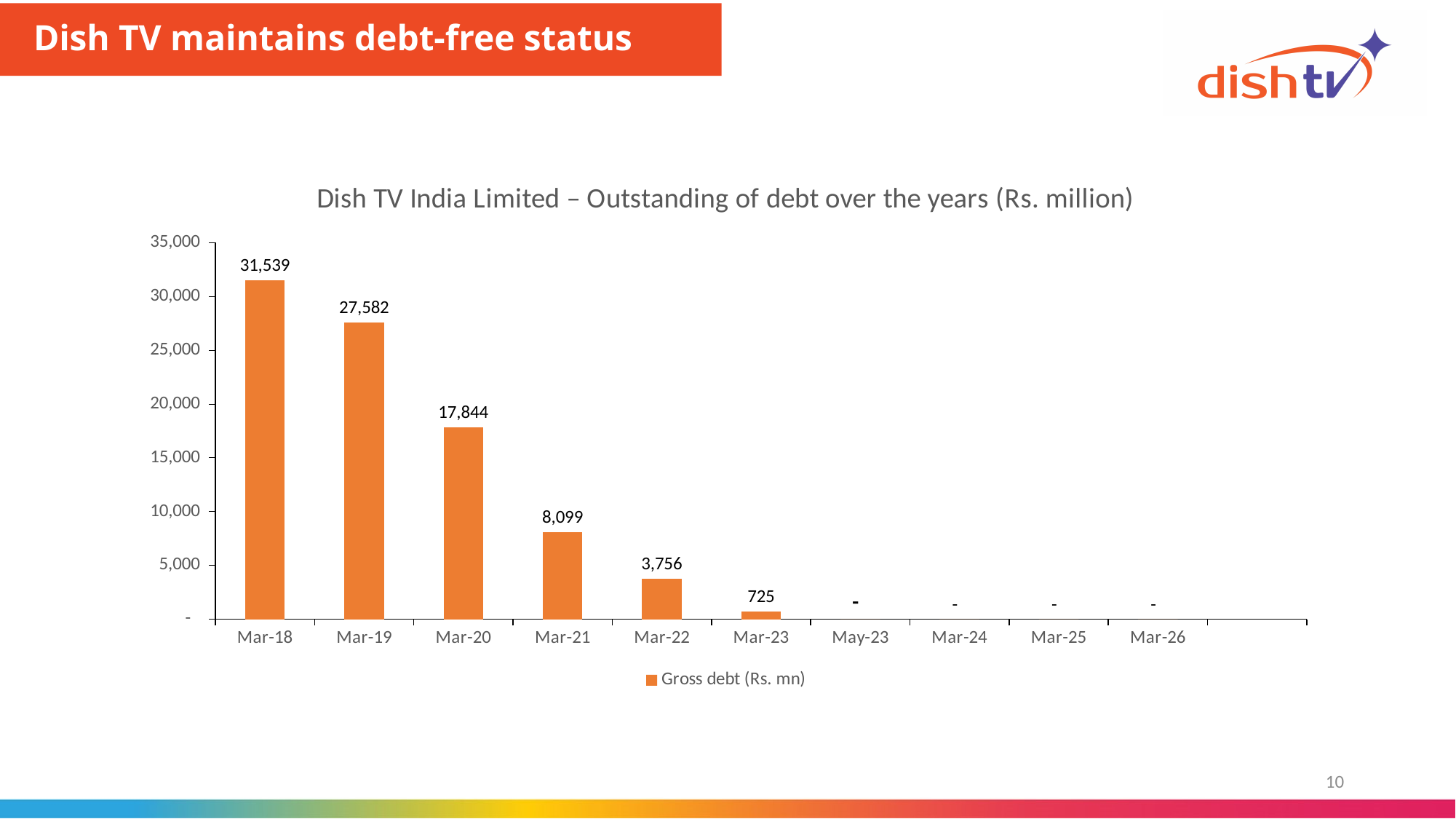
How many periods are shown on the x axis? 10 What kind of chart is shown on the slide? bar chart What is the gross debt value for Mar-23? 725 What is the difference in gross debt between Mar-18 and Mar-19? 3,957 Which period has the highest gross debt? Mar-18 Is the gross debt for Mar-20 greater or less than 20,000? less What is the gross debt value for Mar-21? 8,099 Do the gross debt values rise or fall from Mar-18 to Mar-23? fall What is the gross debt value for Mar-18? 31,539 How many series does the legend list? 1 What is the difference in gross debt between Mar-20 and Mar-21? 9,745 Which is larger, the gross debt for Mar-22 or for Mar-23? Mar-22